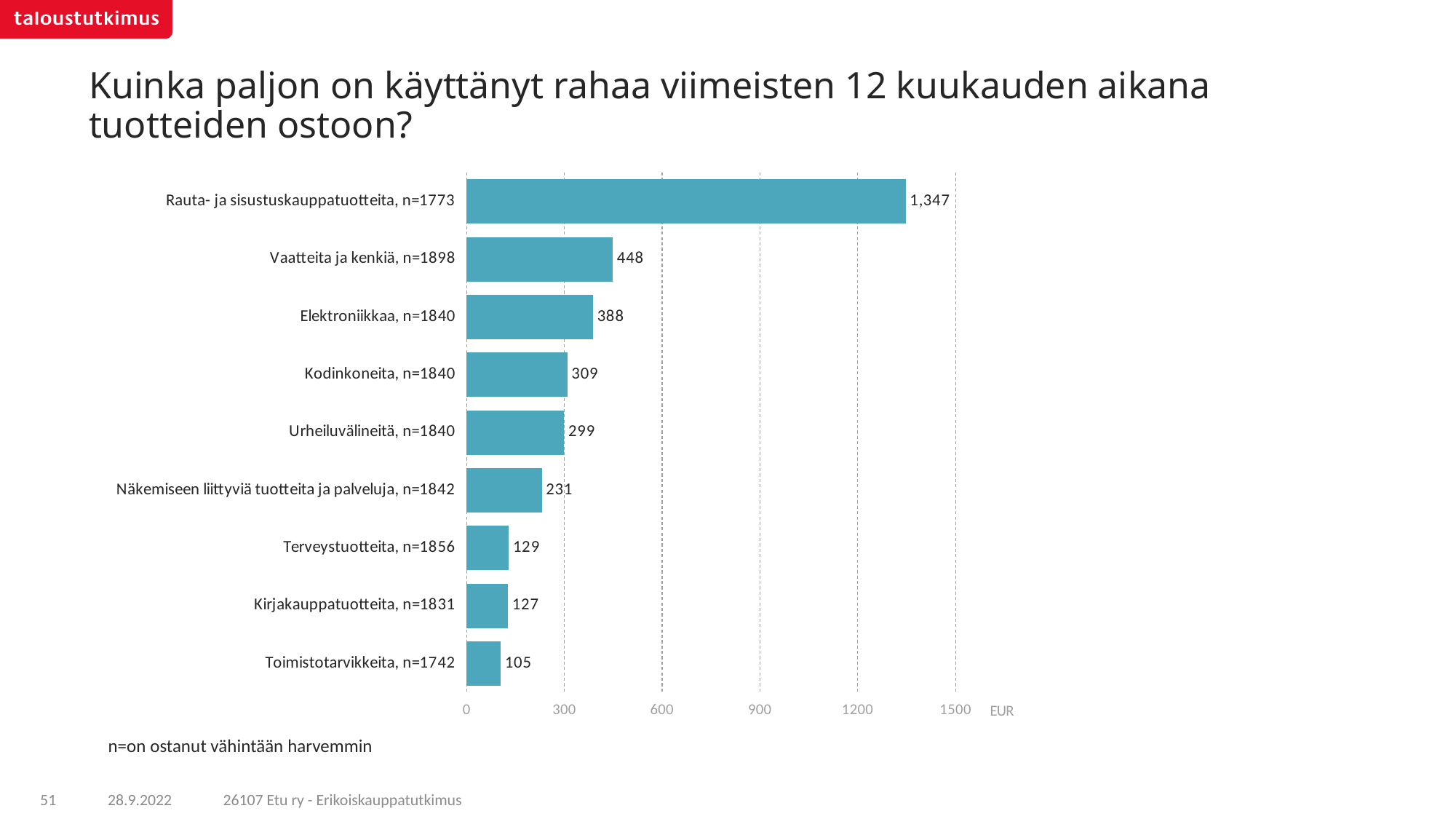
How many categories are shown in the chart? 9 What is the value for Vaatteita ja kenkiä, n=1898? 448 Is the value for Rauta- ja sisustuskauppatuotteita, n=1773 greater or less than 1200? greater What is the difference between the values for Elektroniikkaa, n=1840 and Urheiluvälineitä, n=1840? 89 What unit is shown at the end of the x axis? EUR Which is larger: the value for Näkemiseen liittyviä tuotteita ja palveluja, n=1842 or the value for Terveystuotteita, n=1856? Näkemiseen liittyviä tuotteita ja palveluja, n=1842 What kind of chart is shown on the slide? bar chart What is the value for Toimistotarvikkeita, n=1742? 105 Which category has the highest value? Rauta- ja sisustuskauppatuotteita, n=1773 Which category has the lowest value? Toimistotarvikkeita, n=1742 What is the difference between the values for Kirjakauppatuotteita, n=1831 and Toimistotarvikkeita, n=1742? 22 What is the value for Kodinkoneita, n=1840? 309